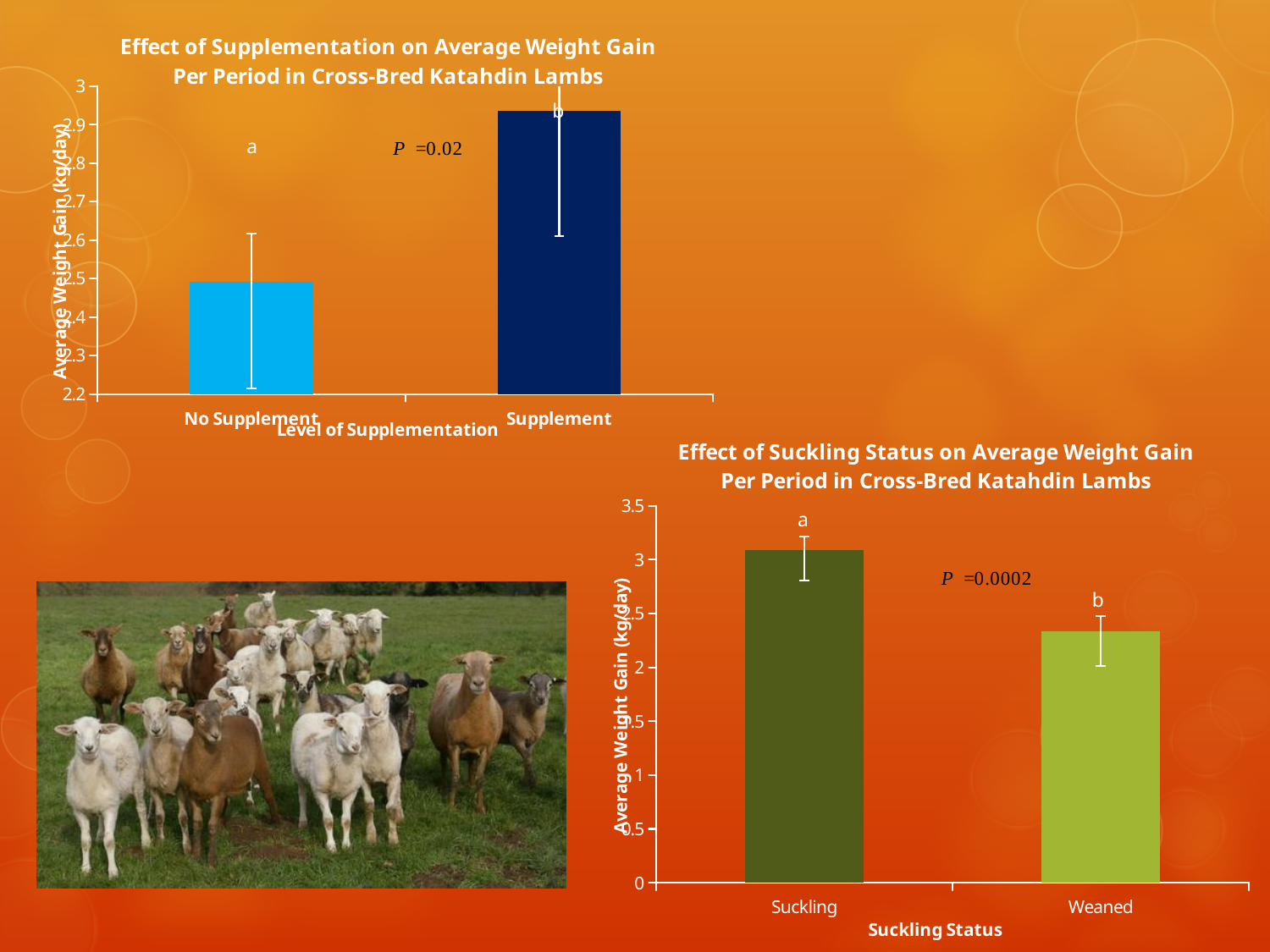
What is the x-axis title of the 'Effect of Suckling Status' chart? Suckling Status In the 'Effect of Suckling Status' chart, is the value for Weaned greater or less than 2.5? less In the 'Effect of Suckling Status' chart, is the value for Suckling greater or less than 2.5? greater In the 'Effect of Supplementation' chart, which level of supplementation has the higher average weight gain? Supplement In the 'Effect of Supplementation' chart, is the value for Supplement greater or less than 2.8? greater What P value is printed on the 'Effect of Supplementation' chart? P =0.02 What type of chart is the 'Effect of Supplementation on Average Weight Gain Per Period in Cross-Bred Katahdin Lambs' chart? bar chart In the 'Effect of Supplementation' chart, which category has the lowest average weight gain? No Supplement In the 'Effect of Suckling Status on Average Weight Gain Per Period in Cross-Bred Katahdin Lambs' chart, which suckling status has the higher average weight gain? Suckling How many categories are shown on the x axis of the 'Effect of Supplementation' chart? 2